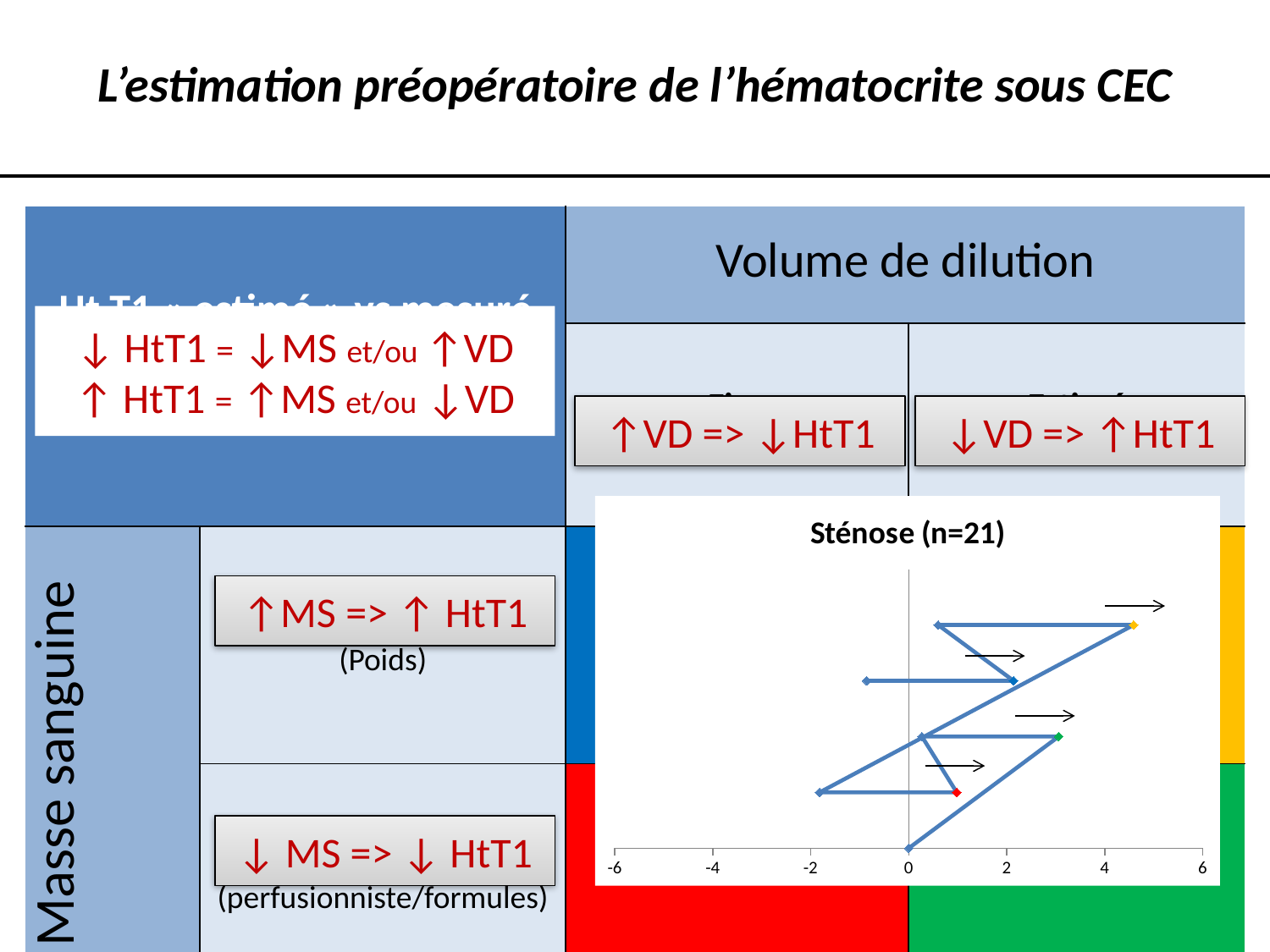
In the Sténose chart, is the x value of the yellow point greater or less than that of the green point? greater What is the lowest value shown on the x axis of the Sténose chart? -6 In the Sténose chart, is the x value of the green point greater or less than 2? greater What is the highest value shown on the x axis of the Sténose chart? 6 How many tick labels are shown on the x axis of the Sténose chart? 7 In the Sténose chart, is the x value of the red point greater or less than 0? greater In the Sténose chart, which coloured point has the largest x value: yellow, green or red? yellow According to the chart title, how many cases (n) are in the Sténose group? 21 In the Sténose chart, is the x value of the red point greater or less than 2? less What is the title of the chart on the slide? Sténose (n=21)